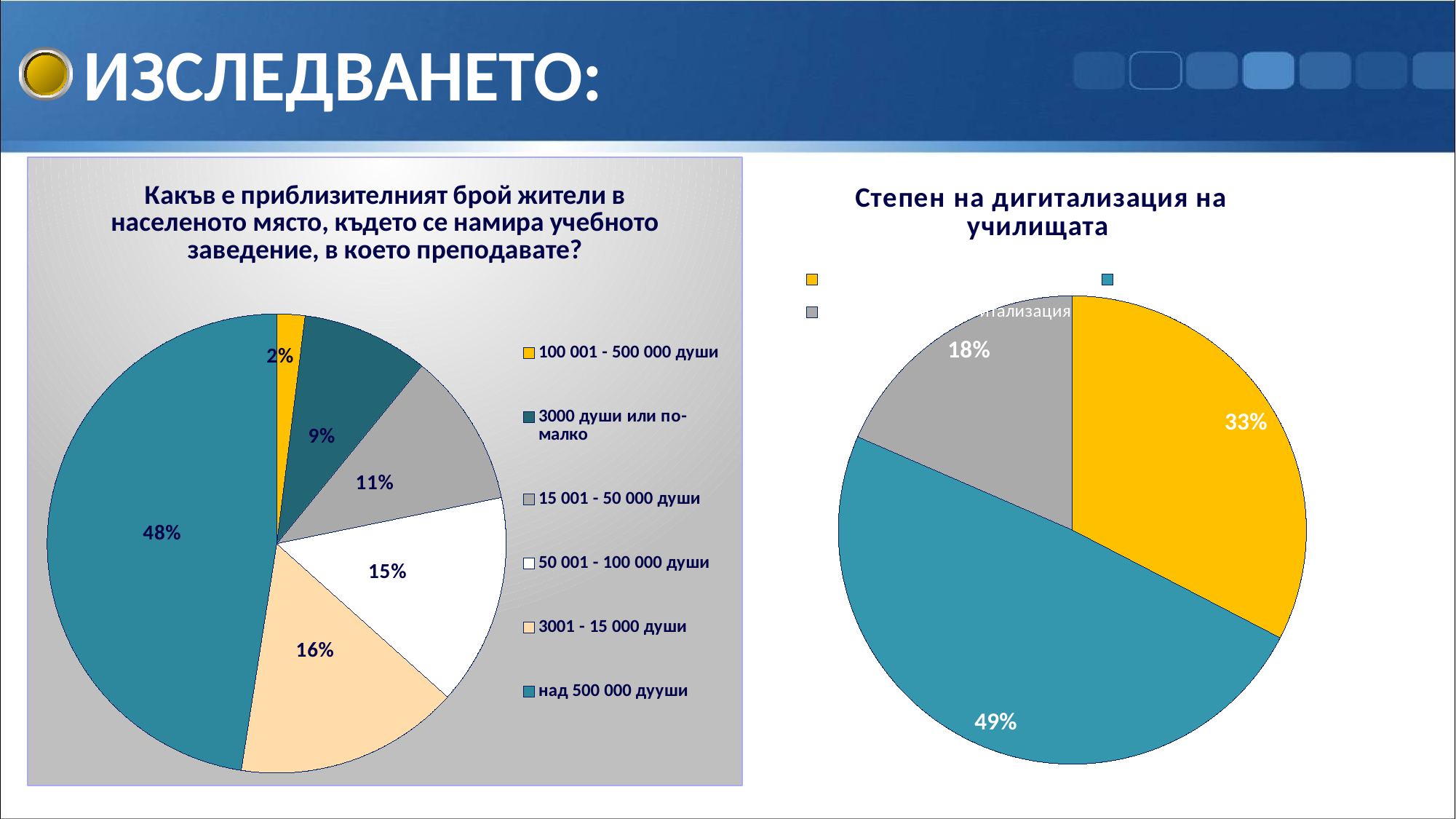
On the left pie chart, what share corresponds to "3000 души или по-малко"? 9% On the left pie chart, which category has the smallest share? 100 001 - 500 000 души How many categories does the legend of the left pie chart list? 6 On the left pie chart, what is the difference between the shares for "50 001 - 100 000 души" and "15 001 - 50 000 души"? 4% On the chart titled "Степен на дигитализация на училищата", how many slices does the pie have? 3 What kind of chart is the chart titled "Степен на дигитализация на училищата"? Pie chart On the chart titled "Степен на дигитализация на училищата", what is the largest slice's share? 49% On the left pie chart, which category has the largest share? над 500 000 дууши On the chart titled "Степен на дигитализация на училищата", what share does the yellow slice have? 33% On the left pie chart, which is larger: the share for "3001 - 15 000 души" or for "50 001 - 100 000 души"? 3001 - 15 000 души On the left pie chart, what share of respondents chose "над 500 000 дууши"? 48% On the left pie chart, what share corresponds to "3001 - 15 000 души"? 16%